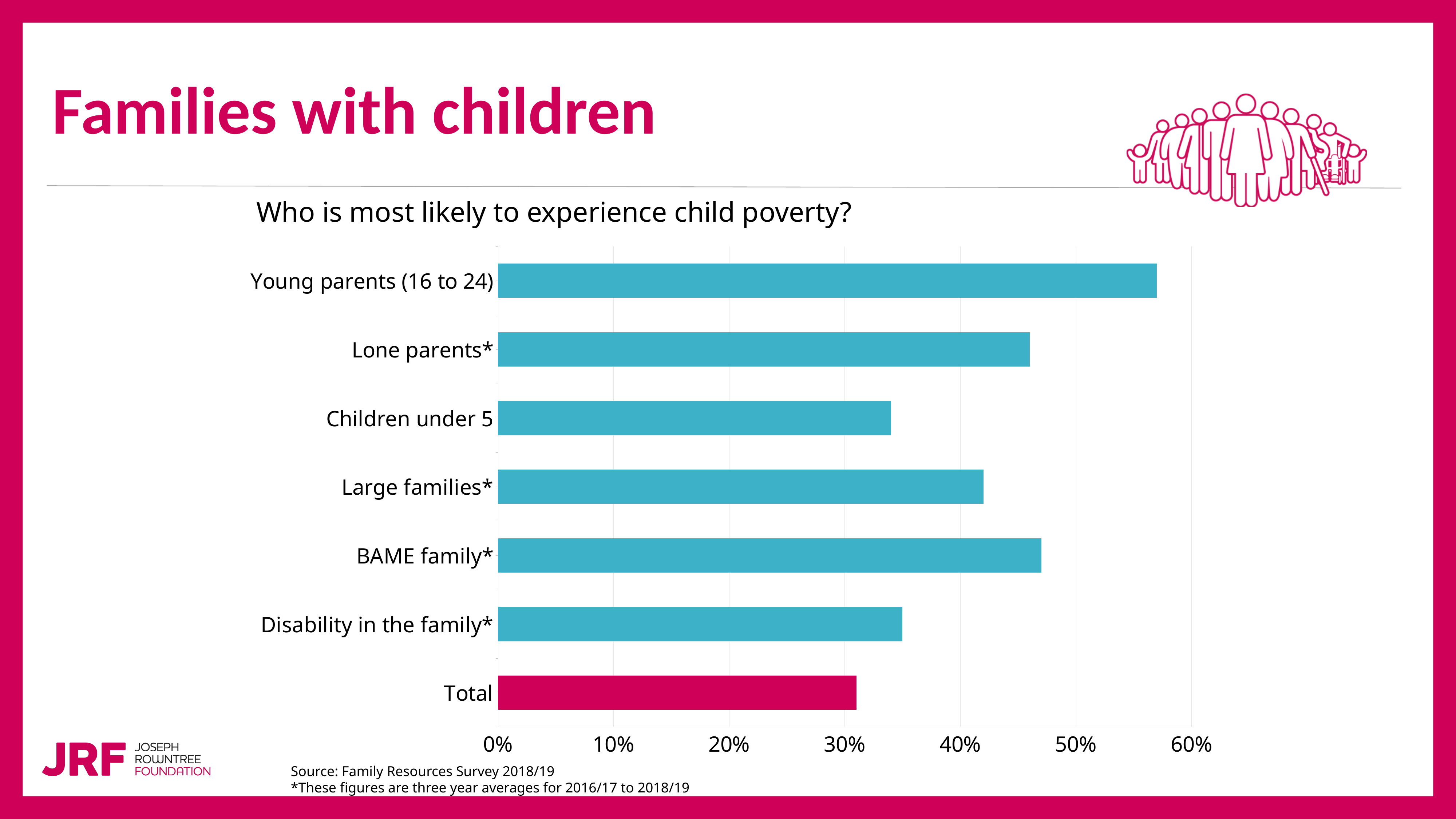
Which is larger, the value for Lone parents* or the value for Children under 5? Lone parents* What kind of chart is shown on the slide? bar chart Is the value for Young parents (16 to 24) greater or less than 50%? greater How many categories are plotted in the chart? 7 Which bar in the chart is coloured differently from the others? Total Which is larger, the value for Disability in the family* or the value for BAME family*? BAME family* Is the value for Large families* greater or less than 40%? greater Which category has the lowest value in the chart? Total What is the title of the chart? Who is most likely to experience child poverty? Is the value for Children under 5 greater or less than 40%? less Which category has the highest value in the chart? Young parents (16 to 24)